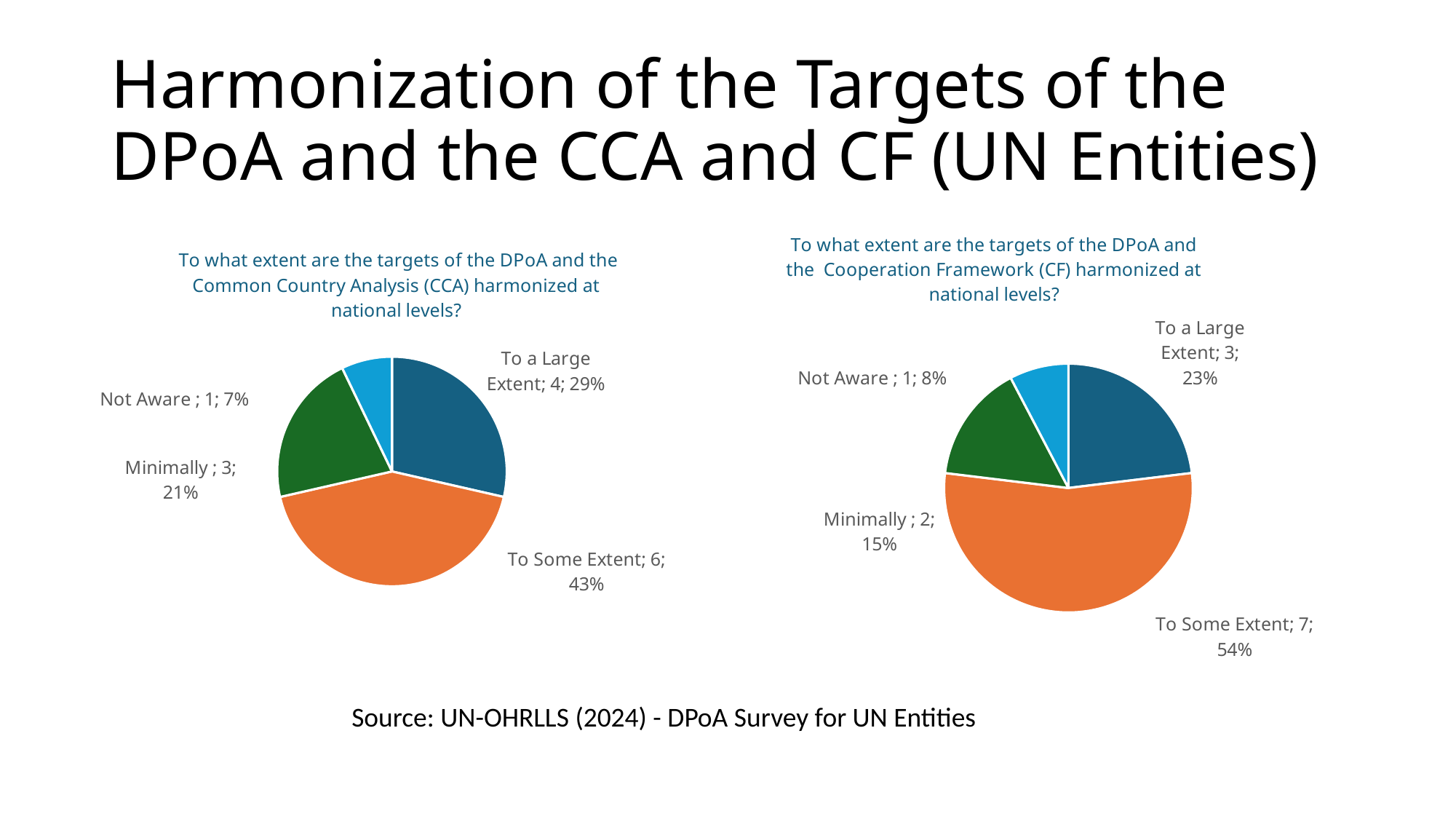
In the right chart (CF), which category has the smallest slice? Not Aware In the right chart (CF), how many respondents answered 'To a Large Extent'? 3 In the left chart (CCA), what share of the pie is 'Minimally'? 21% How many categories does the left chart (CCA) show? 4 What type of chart is the right chart (CF)? Pie chart In the left chart (CCA), how many respondents answered 'To Some Extent'? 6 In the left chart (CCA), which category has the largest slice? To Some Extent In the left chart (CCA), what is the difference in count between 'To Some Extent' and 'To a Large Extent'? 2 In the right chart (CF), which is larger: 'Minimally' or 'To a Large Extent'? To a Large Extent In the left chart (CCA), what is the total number of respondents across all slices? 14 What colour is the 'To Some Extent' slice in both charts? Orange In the right chart (CF), what share of the pie is 'To Some Extent'? 54%